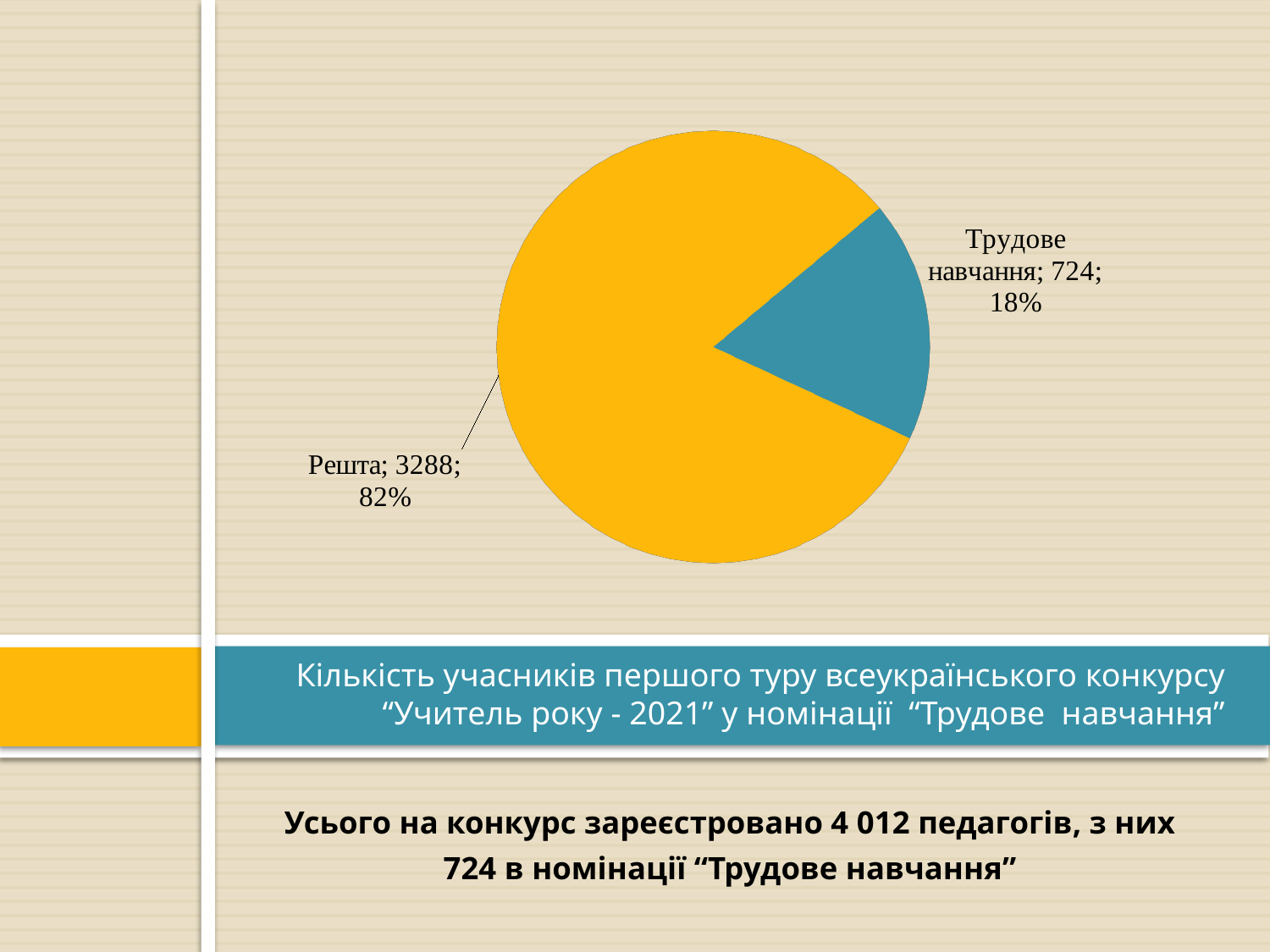
What share of the pie does "Решта" represent? 82% What is the difference between the values for "Решта" and "Трудове навчання"? 2564 What colour is the "Трудове навчання" slice? teal blue Which slice is the smallest? Трудове навчання Which is larger, "Решта" or "Трудове навчання"? Решта What is the total of the two slices in the pie chart? 4012 How many slices does the pie chart have? 2 What is the value for "Трудове навчання"? 724 What is the value for "Решта"? 3288 What kind of chart is shown on the slide? pie chart Which slice is the largest? Решта What share of the pie does "Трудове навчання" represent? 18%